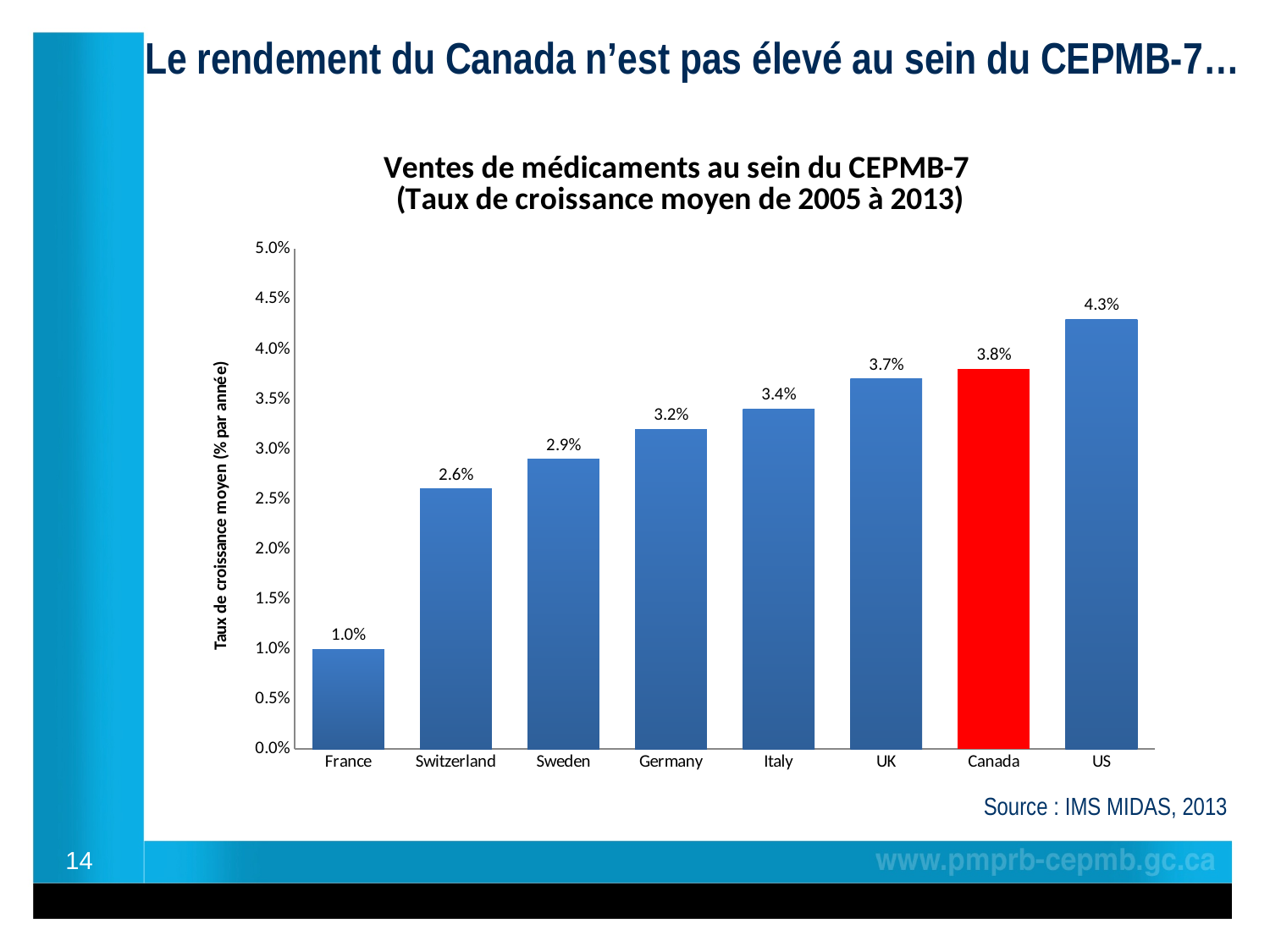
How many countries are shown on the chart? 8 What is the difference between the values for the US and Canada? 0.5% Which has a higher value, Italy or Sweden? Italy Which country has the highest average growth rate? US Which country has the lowest average growth rate? France Is the value for the UK greater or less than 3.0%? greater What is the value shown for Germany? 3.2% What is the average growth rate shown for France? 1.0% What kind of chart is shown on the slide? Bar chart What is the difference between the values for Switzerland and France? 1.6% Which country's bar is coloured red? Canada What is the average growth rate shown for Canada? 3.8%